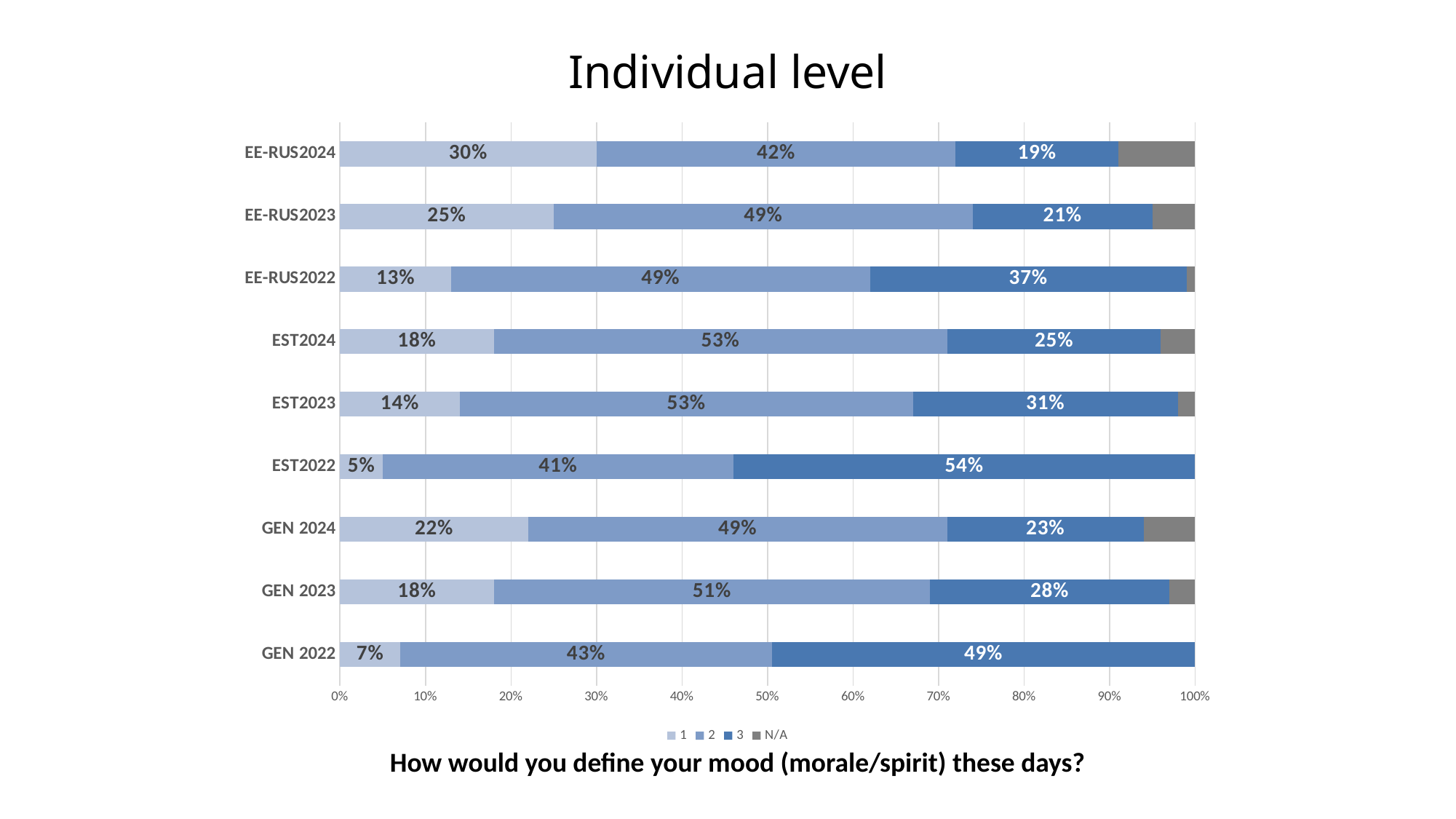
Which category has the lowest value for series 1? EST2022 What is the difference between the series 3 values for EE-RUS2022 and EE-RUS2024? 18% Which category has the highest value for series 3? EST2022 How many series does the legend list? 4 What is the value of series 3 for EST2022? 54% What kind of chart is shown on the slide? Stacked bar chart How many categories are shown on the y axis? 9 Which is larger: the series 1 value for GEN 2024 or for GEN 2022? GEN 2024 What is the title of the chart? Individual level What is the value of series 2 for GEN 2023? 51% What question is shown below the chart? How would you define your mood (morale/spirit) these days? What is the value of series 1 for EE-RUS2024? 30%